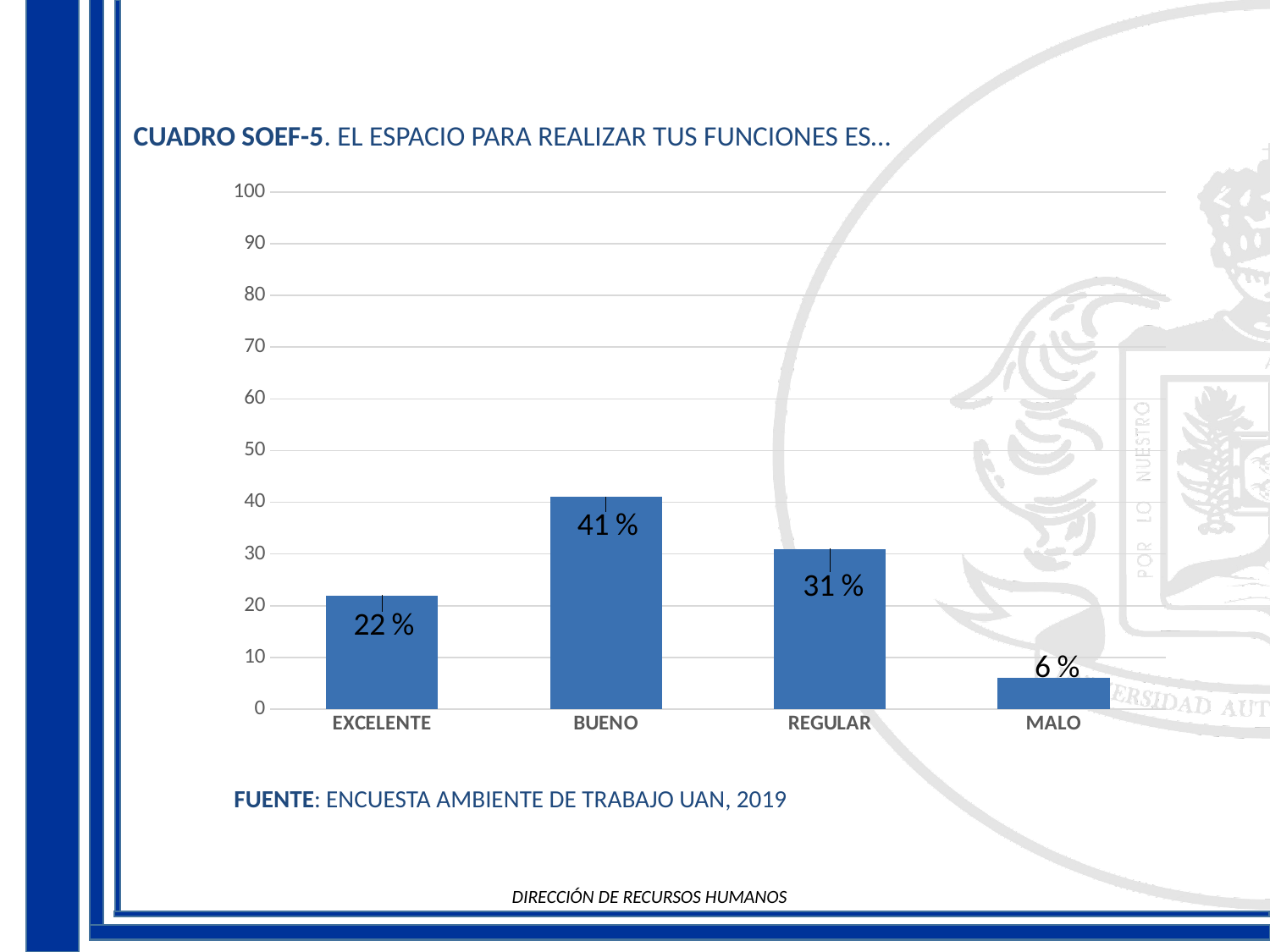
What is the value for REGULAR? 31 % What kind of chart is shown on the slide? bar chart What is the value for BUENO? 41 % Which is larger, the value for EXCELENTE or the value for REGULAR? REGULAR What is the value for MALO? 6 % What is the difference between the values for BUENO and REGULAR? 10 % What source is cited below the chart? ENCUESTA AMBIENTE DE TRABAJO UAN, 2019 Which category has the highest value? BUENO What is the value for EXCELENTE? 22 % How many categories are shown on the x axis? 4 Which category has the lowest value? MALO Is the value for BUENO greater or less than 50? less